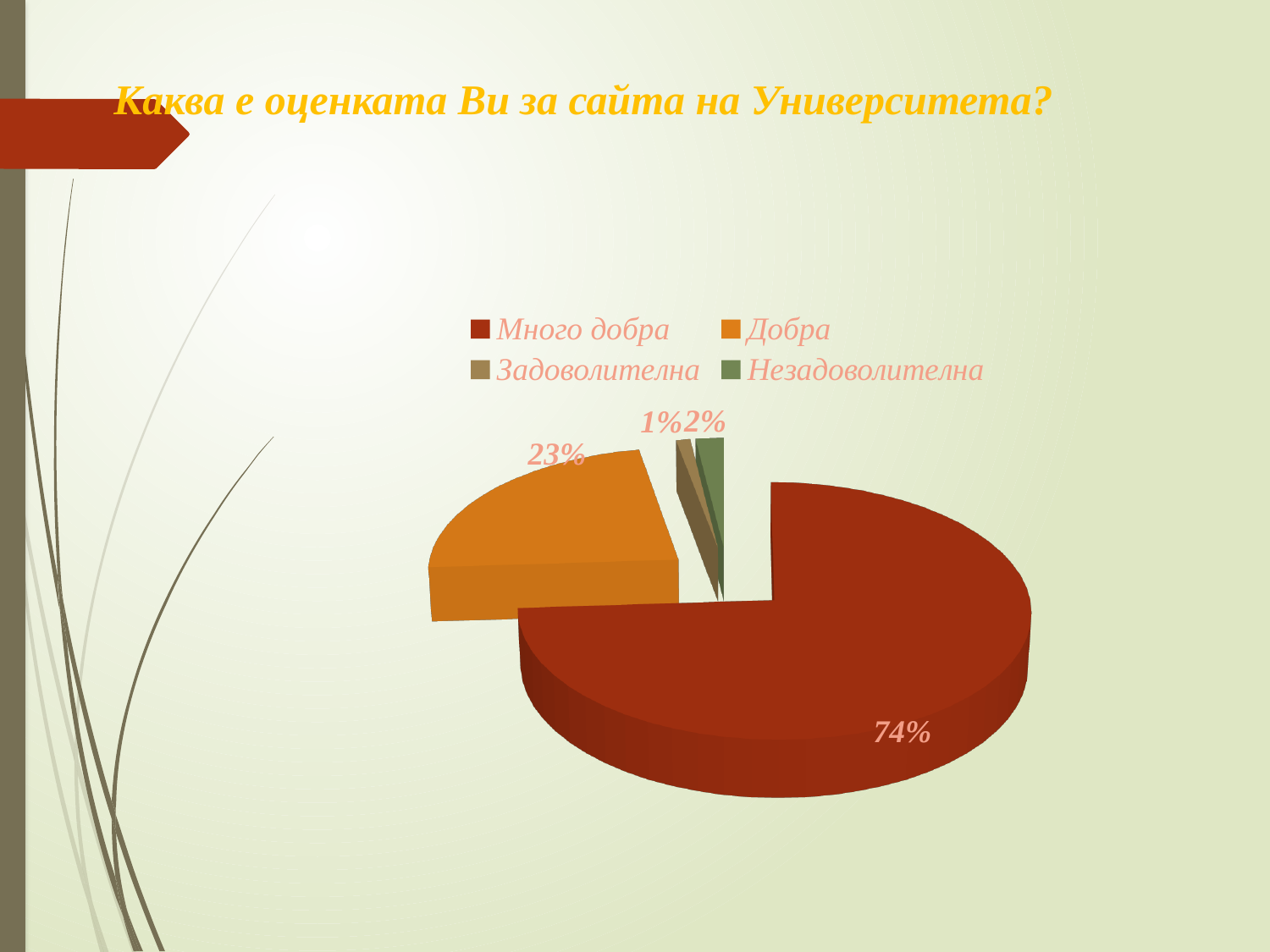
Which category has the largest slice of the pie? Много добра How many categories does the legend of the pie chart list? 4 What share of the pie does "Добра" have? 23% What colour is the slice for "Добра"? orange Which category has the smallest slice of the pie? Задоволителна What share of the pie does "Задоволителна" have? 1% What type of chart is shown on the slide? pie chart What share of the pie does "Незадоволителна" have? 2% Which is larger, the slice for "Добра" or the slice for "Незадоволителна"? Добра What is the difference in percentage points between "Много добра" and "Добра"? 51 What is the title of the chart on the slide? Каква е оценката Ви за сайта на Университета?